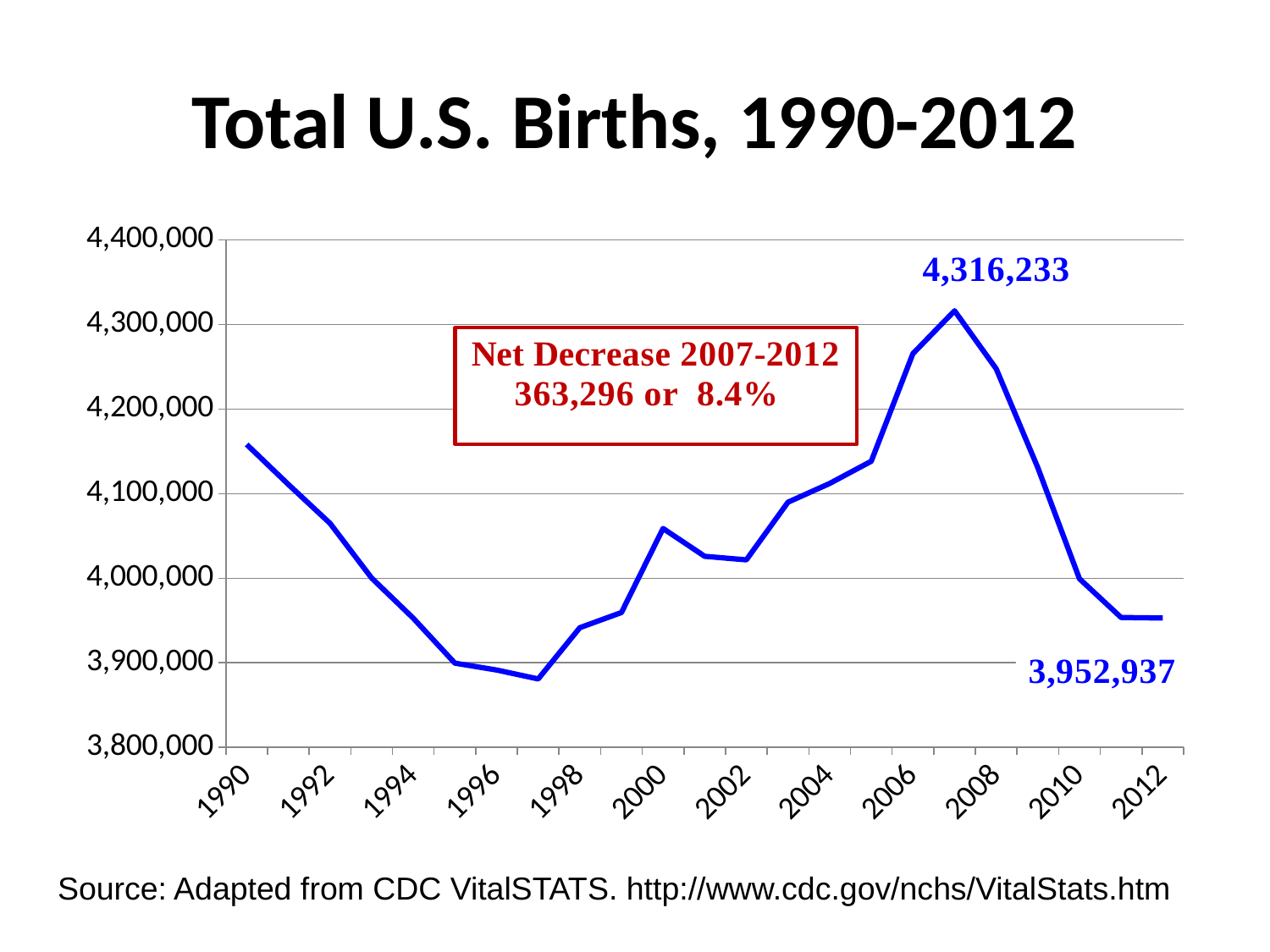
Which year has more births, 1990 or 2012? 1990 Is the value for 1997 greater or less than 3,900,000? less What kind of chart is shown on the slide? line chart Is the value for 2000 greater or less than 4,000,000? greater What is the title of the chart? Total U.S. Births, 1990-2012 What percentage decrease in births from 2007 to 2012 is shown on the chart? 8.4% What is the value of total U.S. births in 2012? 3,952,937 What is the highest value of total U.S. births labeled on the chart? 4,316,233 Do total U.S. births rise or fall from 2007 to 2012? fall What is the net decrease in births from 2007 to 2012? 363,296 Is the value for 1990 greater or less than 4,100,000? greater In which year did total U.S. births reach their highest value? 2007